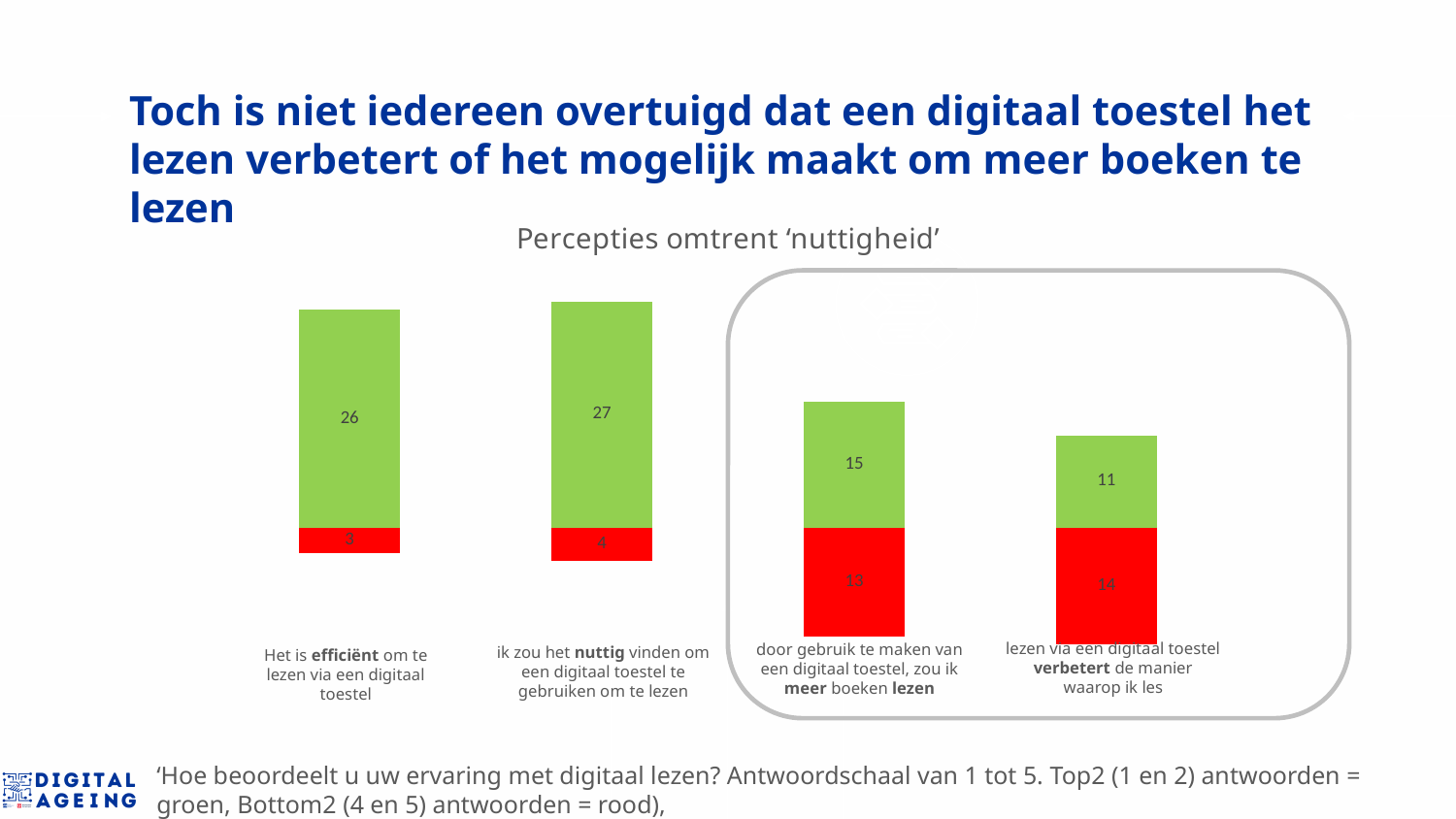
Which statement has the highest green (Top2) value? ik zou het nuttig vinden om een digitaal toestel te gebruiken om te lezen What is the green (Top2) value for 'Het is efficiënt om te lezen via een digitaal toestel'? 26 What kind of chart is shown on the slide? stacked bar chart Which statement has the lowest red (Bottom2) value? Het is efficiënt om te lezen via een digitaal toestel What is the difference between the green and red values for 'Het is efficiënt om te lezen via een digitaal toestel'? 23 Which is larger for 'lezen via een digitaal toestel verbetert de manier waarop ik les': the green value or the red value? the red value What is the total of the stacked bar for 'door gebruik te maken van een digitaal toestel, zou ik meer boeken lezen'? 28 How many statements (categories) are shown in the chart? 4 What is the red (Bottom2) value for 'lezen via een digitaal toestel verbetert de manier waarop ik les'? 14 What is the green (Top2) value for 'door gebruik te maken van een digitaal toestel, zou ik meer boeken lezen'? 15 What is the red (Bottom2) value for 'ik zou het nuttig vinden om een digitaal toestel te gebruiken om te lezen'? 4 What is the title of the chart? Percepties omtrent 'nuttigheid'